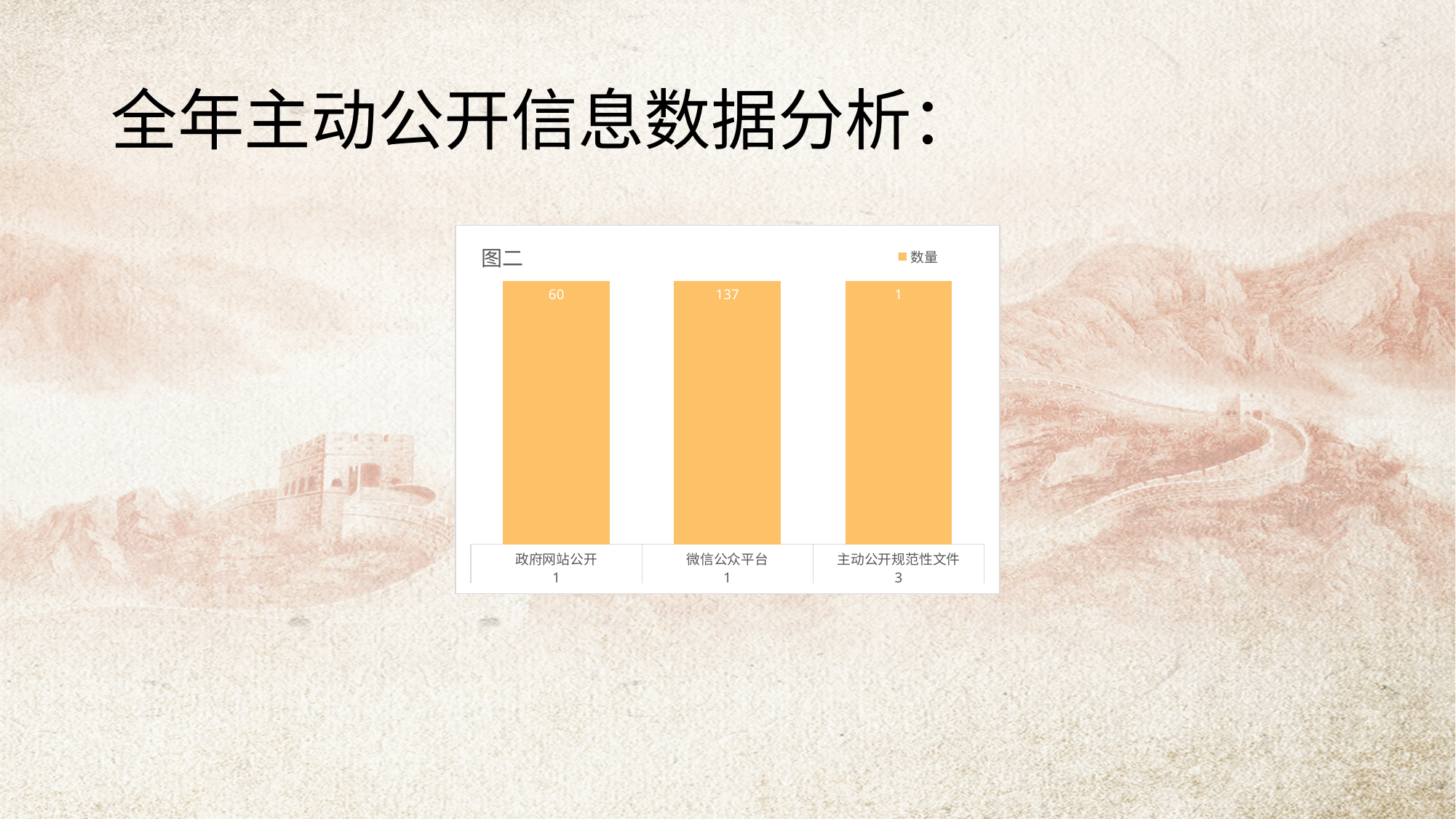
Which is larger, the value for 政府网站公开 or the value for 主动公开规范性文件? 政府网站公开 How many categories are shown in the chart? 3 How many series does the legend list? 1 What is the value for 微信公众平台? 137 What is the name of the series in the legend? 数量 What is the difference between the values for 微信公众平台 and 政府网站公开? 77 Which category has the lowest value? 主动公开规范性文件 What is the value for 主动公开规范性文件? 1 What is the value for 政府网站公开? 60 What is the title of the chart? 图二 Which category has the highest value? 微信公众平台 What kind of chart is shown on the slide? bar chart